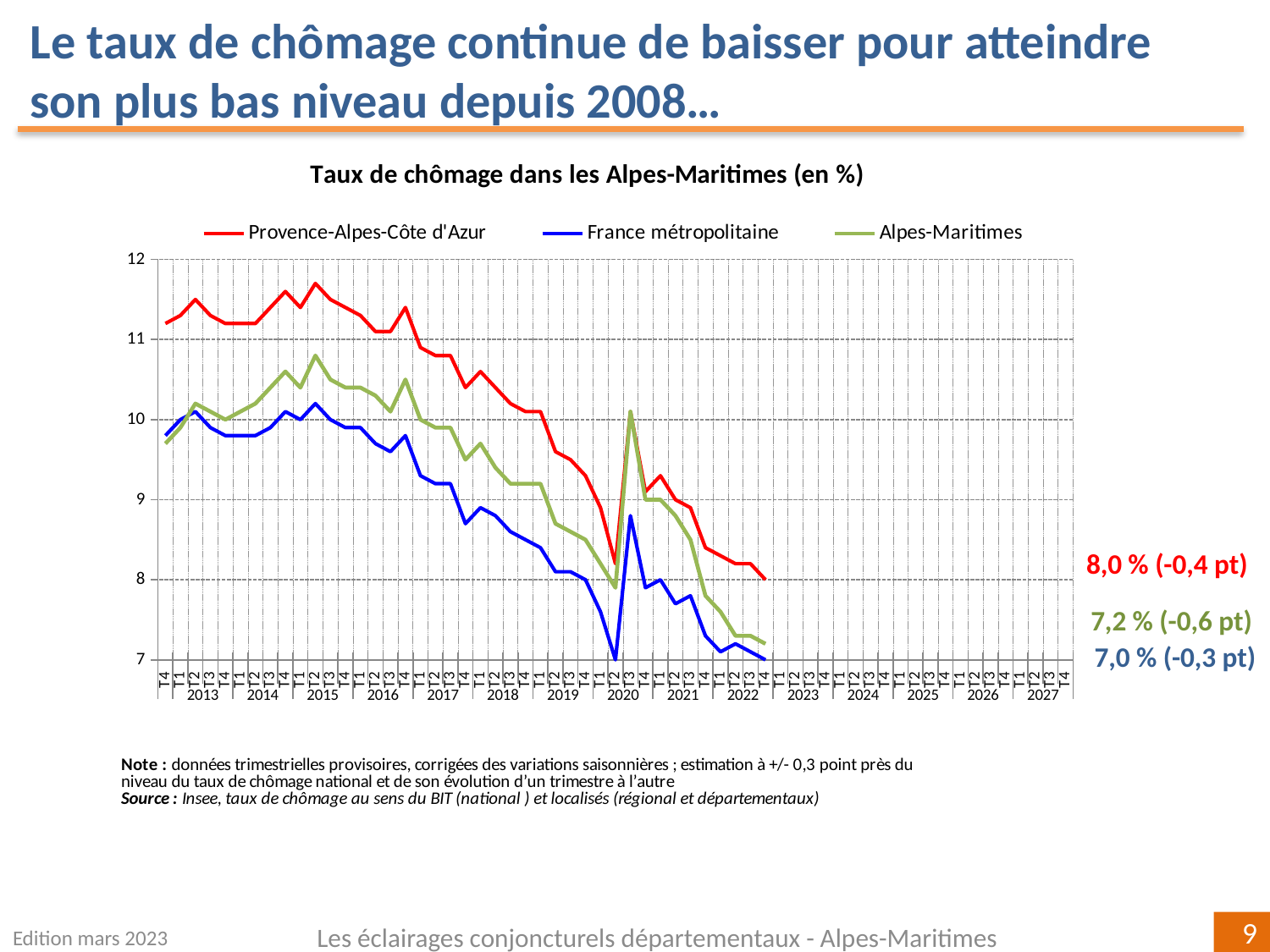
Is the value for Provence-Alpes-Côte d'Azur in T2 2015 greater or less than 11? greater What is the difference between the latest Provence-Alpes-Côte d'Azur rate and the latest France métropolitaine rate? 1,0 pt What kind of chart is shown on the slide? line chart What is the latest unemployment rate shown for Provence-Alpes-Côte d'Azur? 8,0 % Overall, does the Provence-Alpes-Côte d'Azur line rise or fall from 2013 to 2022? fall What is the latest unemployment rate shown for Alpes-Maritimes? 7,2 % At the last point, which is higher: Provence-Alpes-Côte d'Azur or Alpes-Maritimes? Provence-Alpes-Côte d'Azur How many series does the legend list? 3 What is the latest unemployment rate shown for France métropolitaine? 7,0 % By how many points did the Alpes-Maritimes rate change over the last quarter, according to the annotation? -0,6 pt What is the title of the chart? Taux de chômage dans les Alpes-Maritimes (en %) Which series has the highest value at the last plotted point? Provence-Alpes-Côte d'Azur